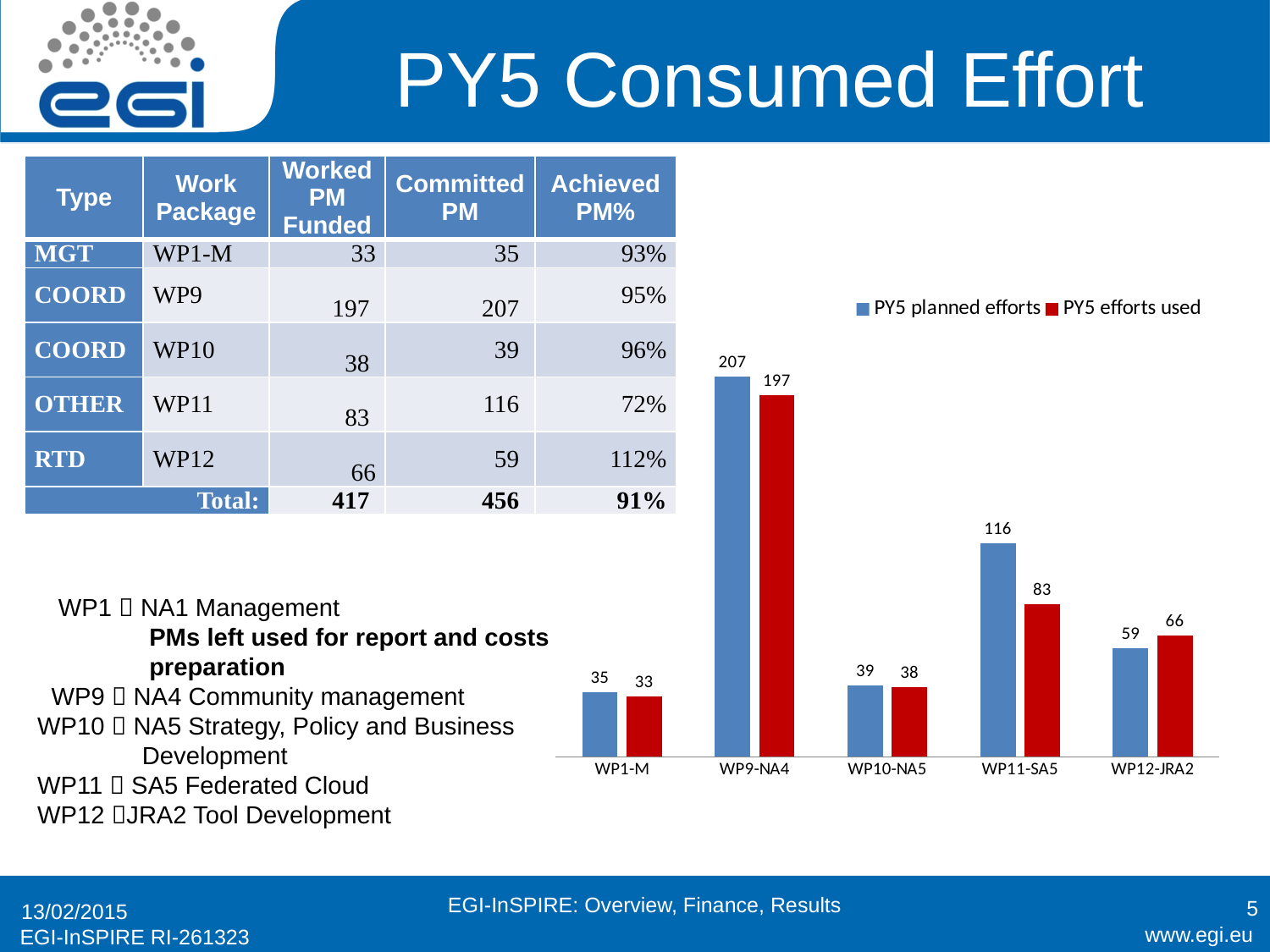
Which category has the lowest PY5 efforts used? WP1-M What is the difference between PY5 planned efforts and PY5 efforts used for WP9-NA4? 10 How many categories are shown on the x axis of the chart? 5 Which category has the highest PY5 planned efforts? WP9-NA4 How many series does the chart legend list? 2 What colour represents the PY5 efforts used series in the chart? red What is the difference between PY5 planned efforts and PY5 efforts used for WP11-SA5? 33 What is the PY5 efforts used value for WP11-SA5? 83 For WP12-JRA2, which is larger: PY5 planned efforts or PY5 efforts used? PY5 efforts used What is the PY5 efforts used value for WP12-JRA2? 66 What is the PY5 planned efforts value for WP9-NA4? 207 What kind of chart is shown on the slide? bar chart